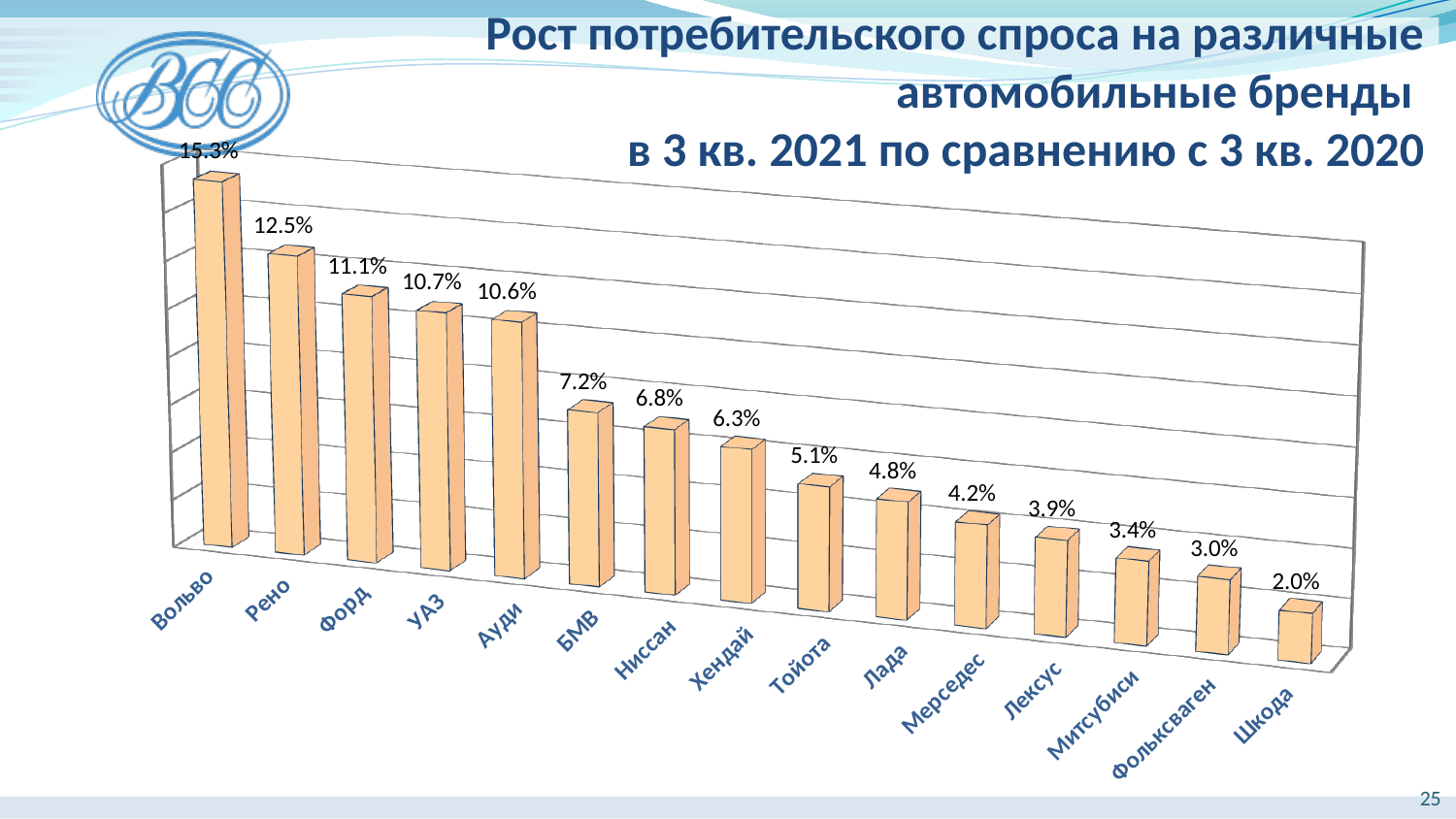
Which brand has the highest value? Вольво What is the value for Вольво? 15.3% What is the difference between the values for Рено and Форд? 1.4% What is the difference between the values for БМВ and Лада? 2.4% Do the values rise or fall from left to right along the x axis? Fall What is the value for Лексус? 3.9% What kind of chart is shown on the slide? Bar chart Which is larger, the value for Тойота or the value for Мерседес? Тойота What is the value for Хендай? 6.3% How many brands are shown in the chart? 15 Which brand has the lowest value? Шкода What is the value for Фольксваген? 3.0%